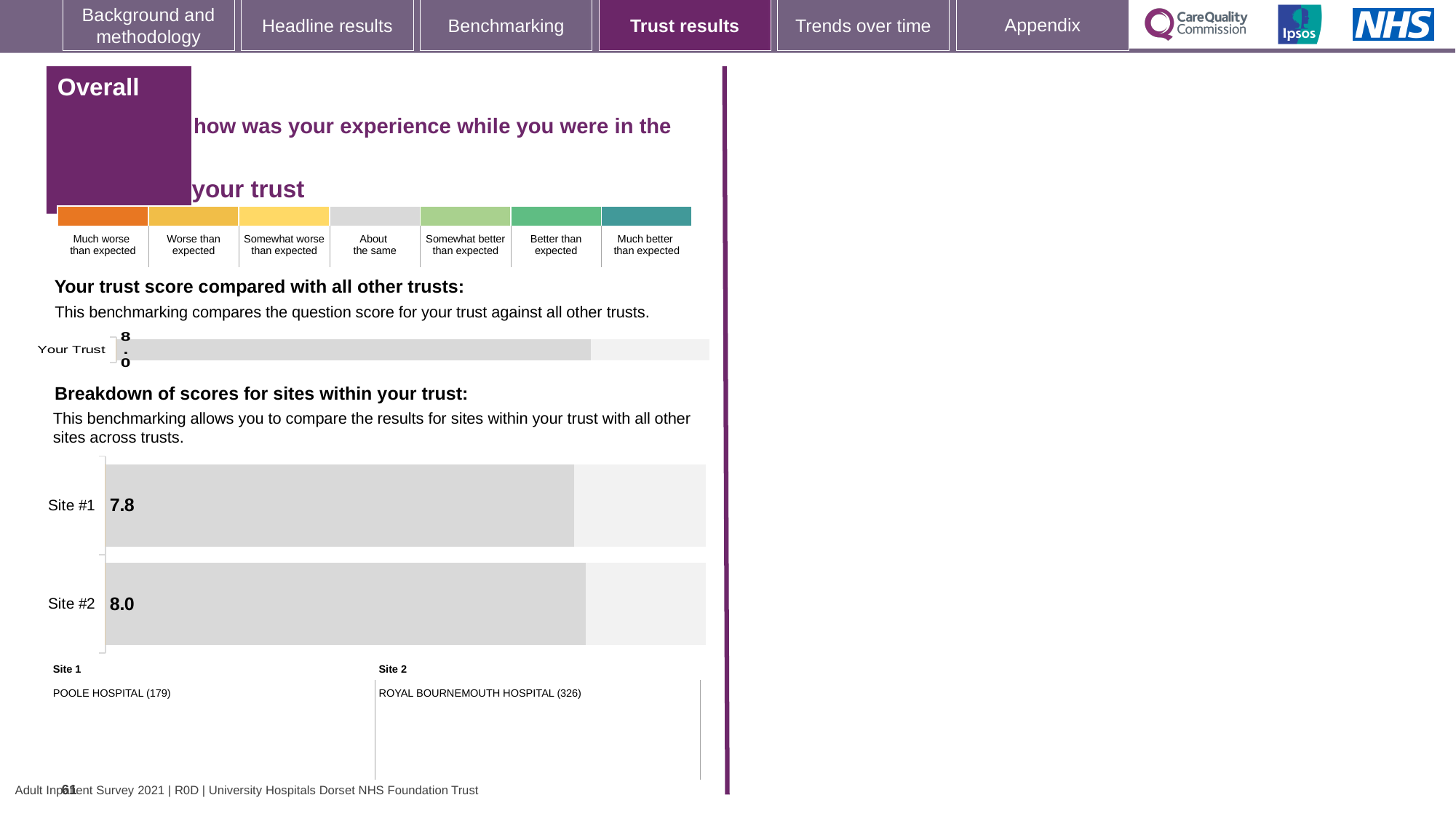
In the 'Breakdown of scores for sites within your trust' chart, what is the difference between the scores of Site #2 and Site #1? 0.2 According to the site key below the charts, which hospital is Site 2? ROYAL BOURNEMOUTH HOSPITAL (326) What kind of chart is the 'Breakdown of scores for sites within your trust' chart? bar chart According to the site key below the charts, which hospital is Site 1? POOLE HOSPITAL (179) In the 'Your trust score compared with all other trusts' chart, what is the score shown for Your Trust? 8.0 In the 'Breakdown of scores for sites within your trust' chart, which site has the lower score? Site #1 In the 'Breakdown of scores for sites within your trust' chart, which site has the higher score? Site #2 In the 'Breakdown of scores for sites within your trust' chart, what is the score for Site #1? 7.8 In the 'Breakdown of scores for sites within your trust' chart, what is the score for Site #2? 8.0 In the 'Breakdown of scores for sites within your trust' chart, is the score for Site #1 larger or smaller than the score for Site #2? smaller How many bars are shown in the 'Your trust score compared with all other trusts' chart? 1 How many sites are plotted in the 'Breakdown of scores for sites within your trust' chart? 2